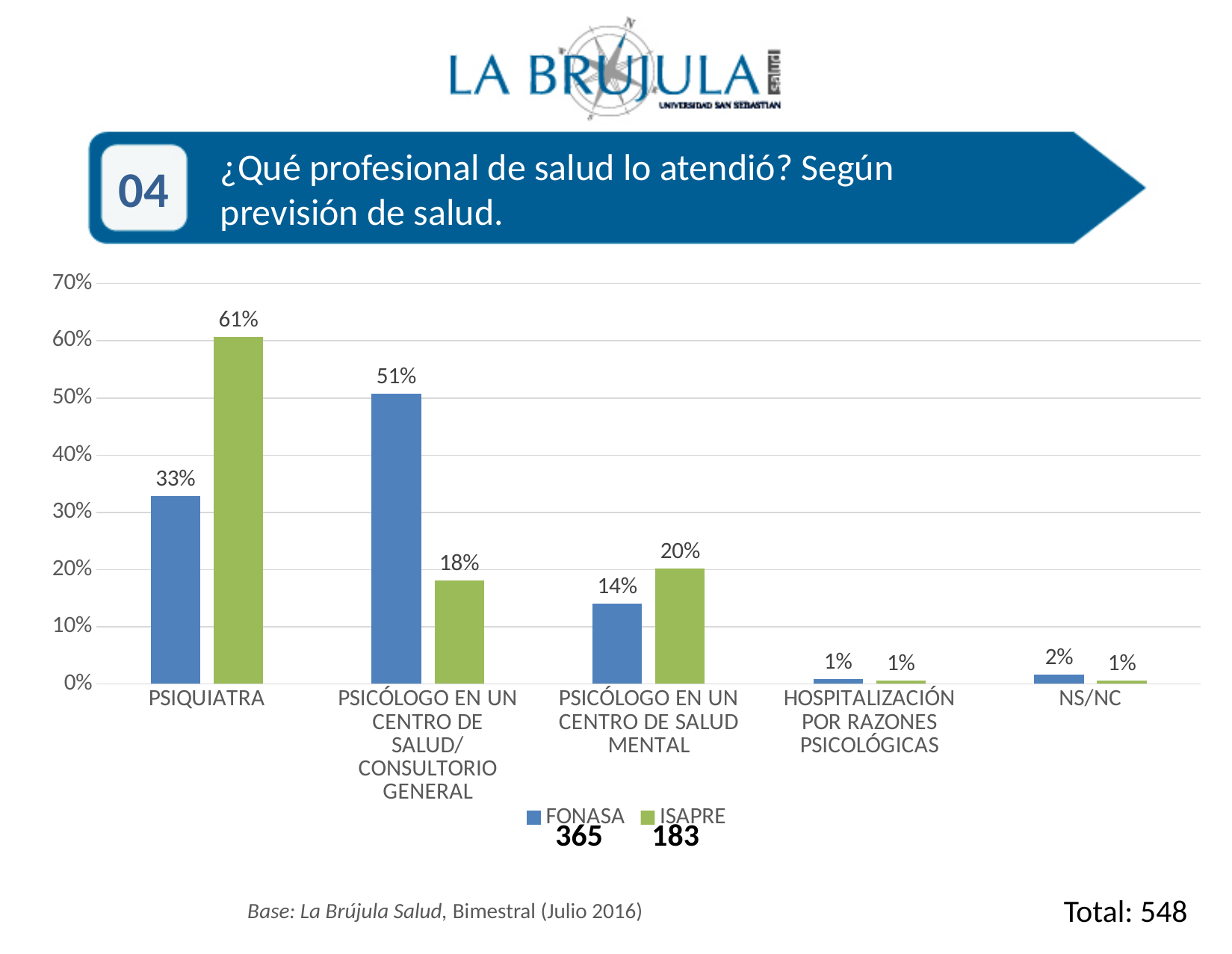
What is the difference between the ISAPRE and FONASA values for PSIQUIATRA? 28% For PSICÓLOGO EN UN CENTRO DE SALUD/CONSULTORIO GENERAL, which series has the larger value, FONASA or ISAPRE? FONASA What is the FONASA value for PSICÓLOGO EN UN CENTRO DE SALUD/CONSULTORIO GENERAL? 51% How many series does the legend list? 2 What kind of chart is shown on the slide? bar chart How many categories are shown on the x axis? 5 What is the FONASA value for PSIQUIATRA? 33% Which category has the highest FONASA value? PSICÓLOGO EN UN CENTRO DE SALUD/CONSULTORIO GENERAL What is the ISAPRE value for PSICÓLOGO EN UN CENTRO DE SALUD MENTAL? 20% Which category has the highest ISAPRE value? PSIQUIATRA What is the ISAPRE value for PSIQUIATRA? 61% Is the ISAPRE value for PSIQUIATRA greater or less than 50%? greater